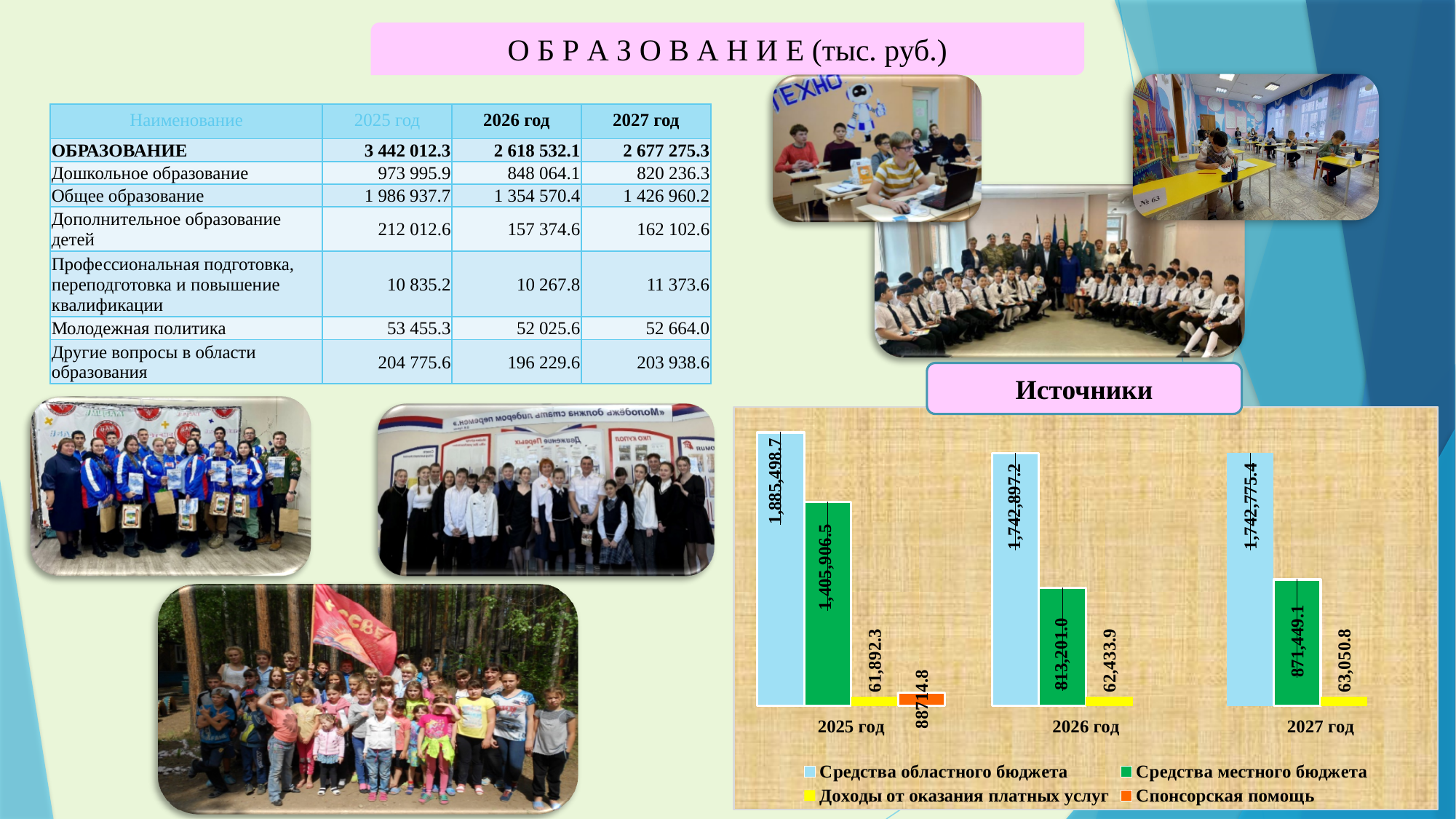
On the 'Источники' chart, what is the value of Спонсорская помощь for 2025 год? 88714.8 How many years (categories) are shown on the 'Источники' chart? 3 On the 'Источники' chart, what is the value of Средства местного бюджета for 2026 год? 813,201.0 On the 'Источники' chart, what is the value of Доходы от оказания платных услуг for 2027 год? 63,050.8 How many series does the legend of the 'Источники' chart list? 4 On the 'Источники' chart, in which year is Средства областного бюджета highest? 2025 год On the 'Источники' chart, in which year is Средства местного бюджета lowest? 2026 год What kind of chart is the 'Источники' chart? Bar chart On the 'Источники' chart, which is larger for 2025 год: Средства областного бюджета or Средства местного бюджета? Средства областного бюджета On the 'Источники' chart, what is the difference between Средства областного бюджета in 2025 год and 2026 год? 142,601.5 On the 'Источники' chart, by how much does Средства местного бюджета in 2027 год exceed that in 2026 год? 58,248.1 On the 'Источники' chart, what is the value of Средства областного бюджета for 2025 год? 1,885,498.7